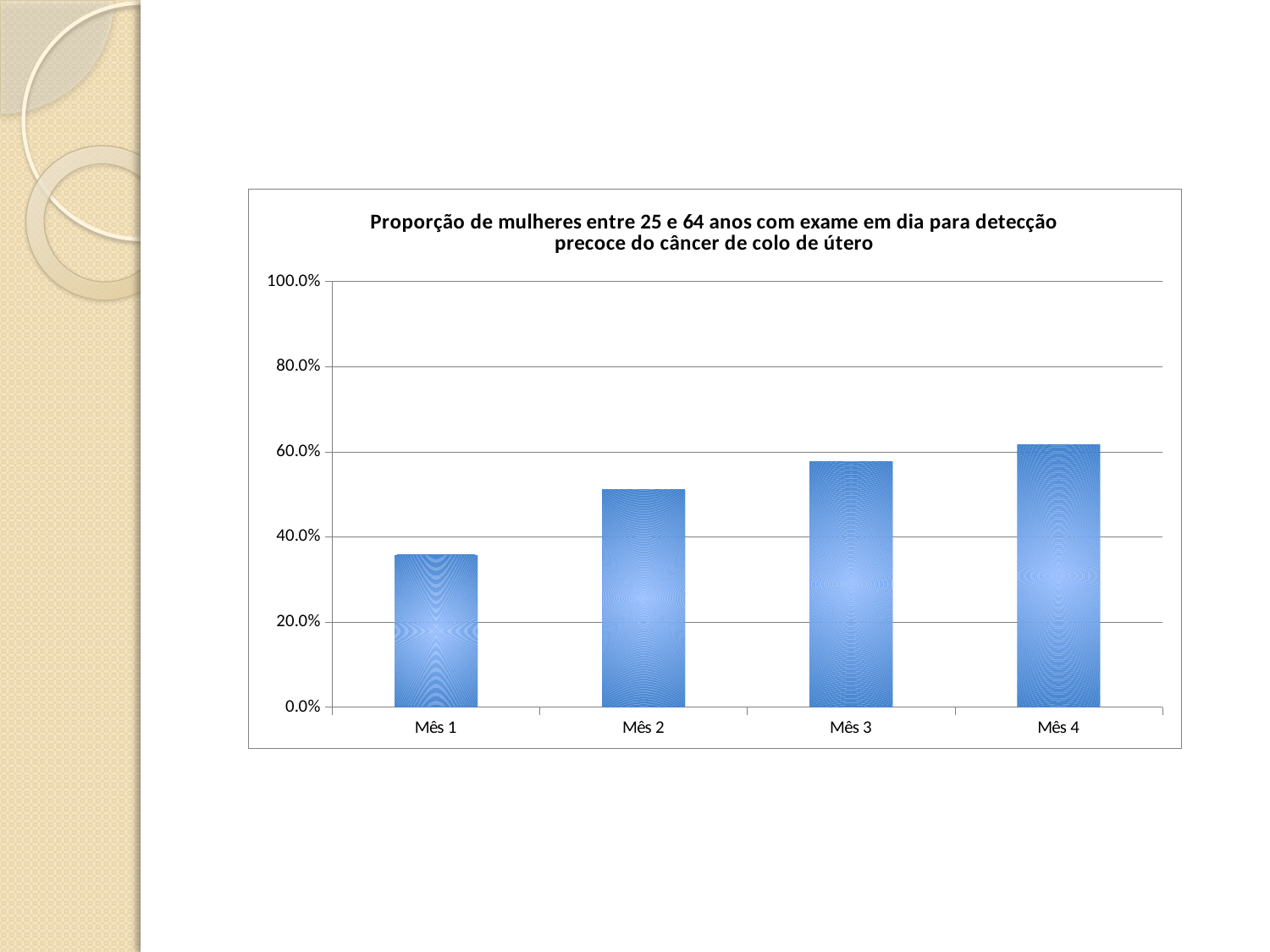
Is the value for Mês 2 greater or less than 40.0%? greater Which is larger, the value for Mês 1 or the value for Mês 2? Mês 2 Which month has the highest value on the chart? Mês 4 Is the value for Mês 1 greater or less than 40.0%? less Do the values rise or fall from Mês 1 to Mês 4? rise Is the value for Mês 3 greater or less than 40.0%? greater How many categories (months) are plotted on the chart? 4 Which month has the lowest value on the chart? Mês 1 What is the title of the chart? Proporção de mulheres entre 25 e 64 anos com exame em dia para detecção precoce do câncer de colo de útero What kind of chart is shown on the slide? bar chart